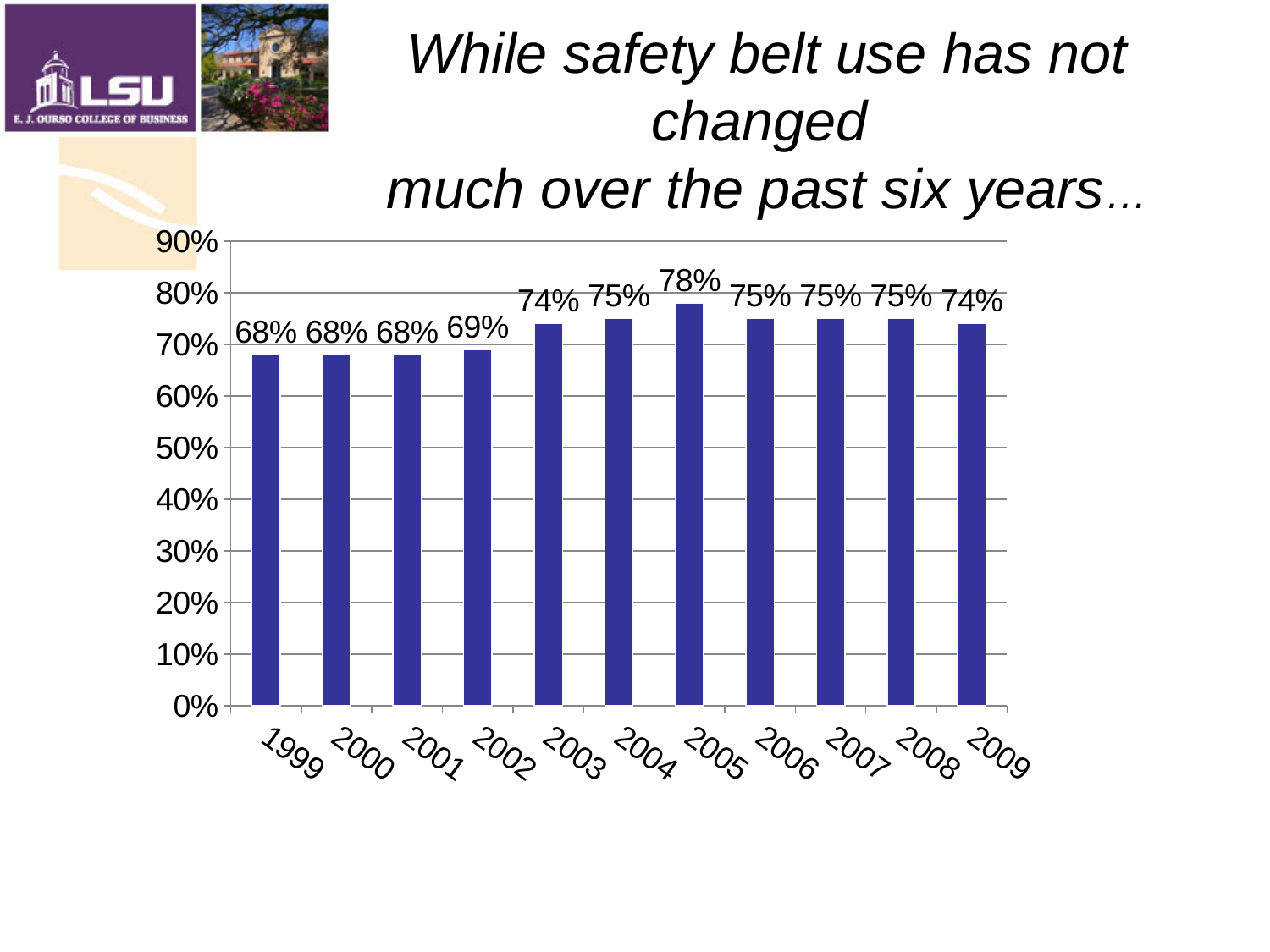
What is the safety belt use value for 2005? 78% What is the value shown for 2009? 74% Is the value for 2005 greater or less than 70%? greater What is the highest value shown on the y axis? 90% How many years are shown on the x axis? 11 What kind of chart is shown on the slide? Bar chart What is the value shown for 2002? 69% What is the difference between the 2003 value and the 2002 value? 5% What is the difference between the 2005 value and the 1999 value? 10% What is the value shown for 1999? 68% Which year has the highest safety belt use? 2005 Which is larger, the value for 2004 or the value for 2002? 2004